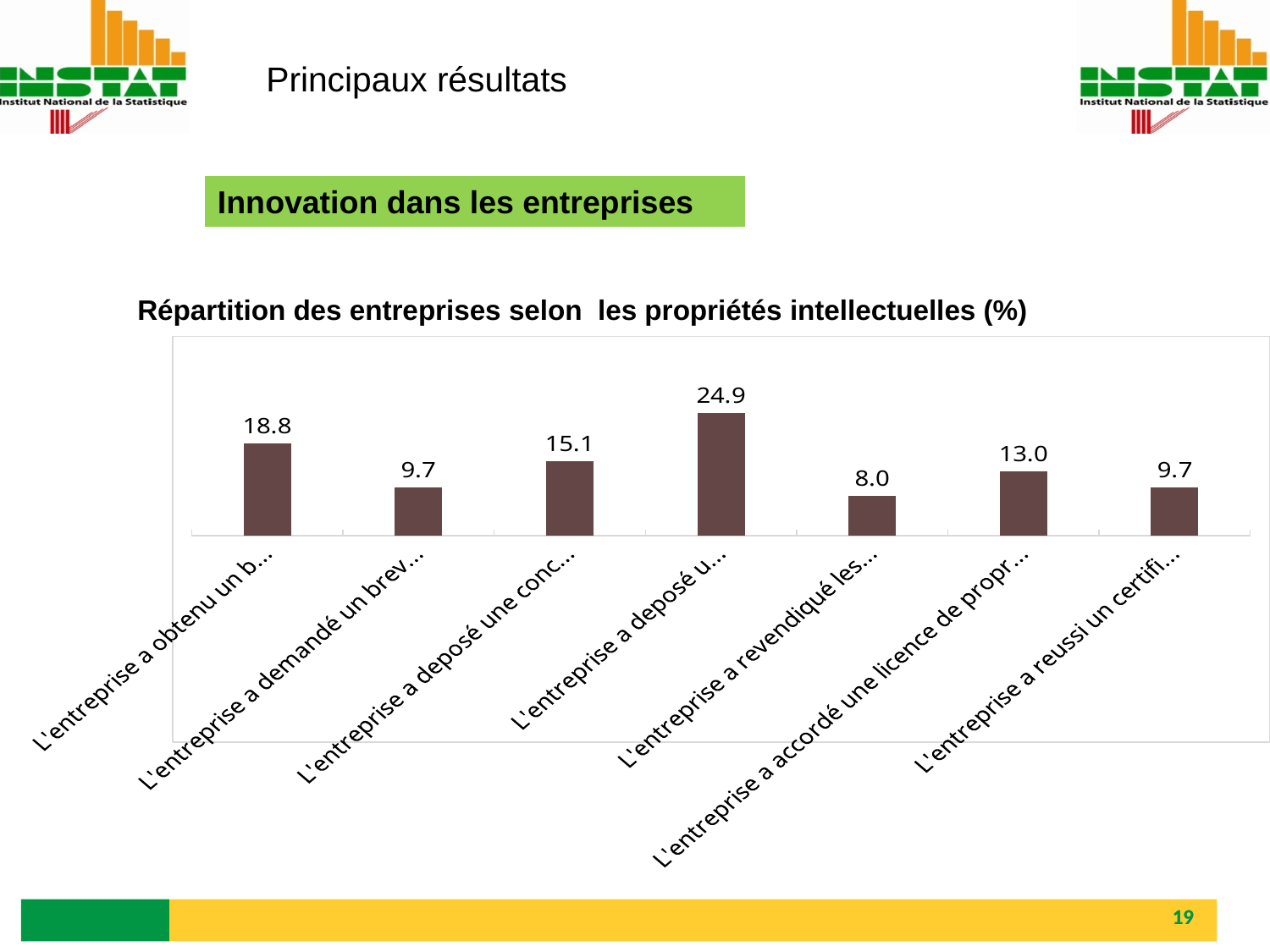
Which bar has the lowest value? L'entreprise a revendiqué les... (fifth bar), 8.0 Which is larger: the value for "L'entreprise a obtenu un b..." or the value for "L'entreprise a deposé une conc..."? L'entreprise a obtenu un b... (18.8) What is the value of the third bar, labelled "L'entreprise a deposé une conc..."? 15.1 What is the value of the bar labelled "L'entreprise a revendiqué les..."? 8.0 Which bar has the highest value? L'entreprise a deposé u... (fourth bar), 24.9 What is the title of the chart? Répartition des entreprises selon les propriétés intellectuelles (%) What is the value of the bar labelled "L'entreprise a accordé une licence de propr..."? 13.0 What is the value of the fourth bar, labelled "L'entreprise a deposé u..."? 24.9 What is the value of the first bar, labelled "L'entreprise a obtenu un b..."? 18.8 How many bars (categories) does the chart show? 7 What is the difference between the highest value (24.9) and the lowest value (8.0)? 16.9 What type of chart is shown on the slide? bar chart